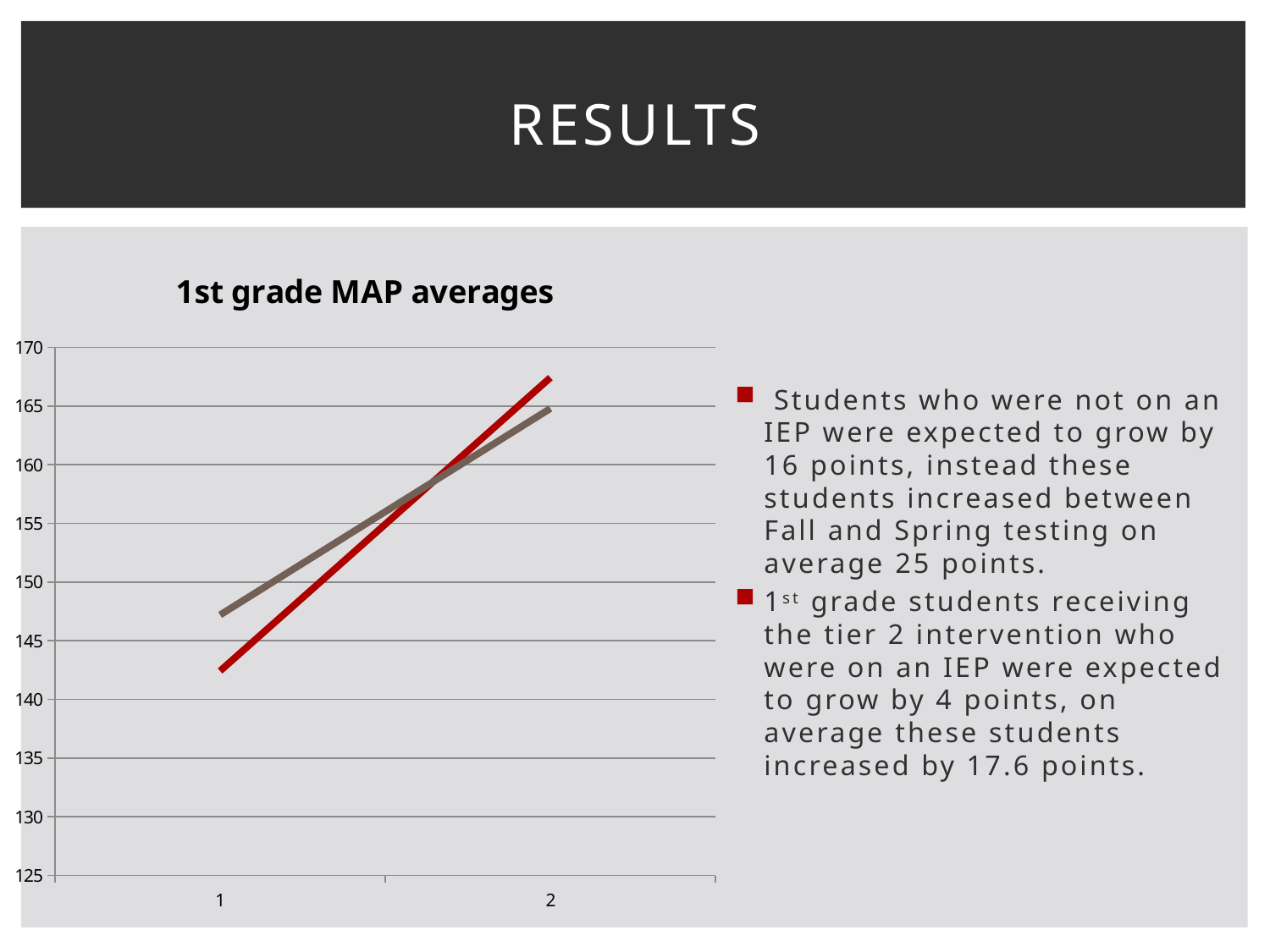
What is the title of the chart? 1st grade MAP averages What kind of chart is shown on the slide? line chart Is the value of the red line at category 2 greater or less than 165? greater How many categories are shown on the x axis of the chart? 2 At category 2, which line has the higher value, the red line or the gray line? the red line How many lines are plotted on the chart? 2 At category 1, which line has the higher value, the red line or the gray line? the gray line Is the value of the gray line at category 2 greater or less than 160? greater Do the values of the red line rise or fall from category 1 to category 2? rise Do the values of the gray line rise or fall from category 1 to category 2? rise Is the value of the red line at category 1 greater or less than 145? less